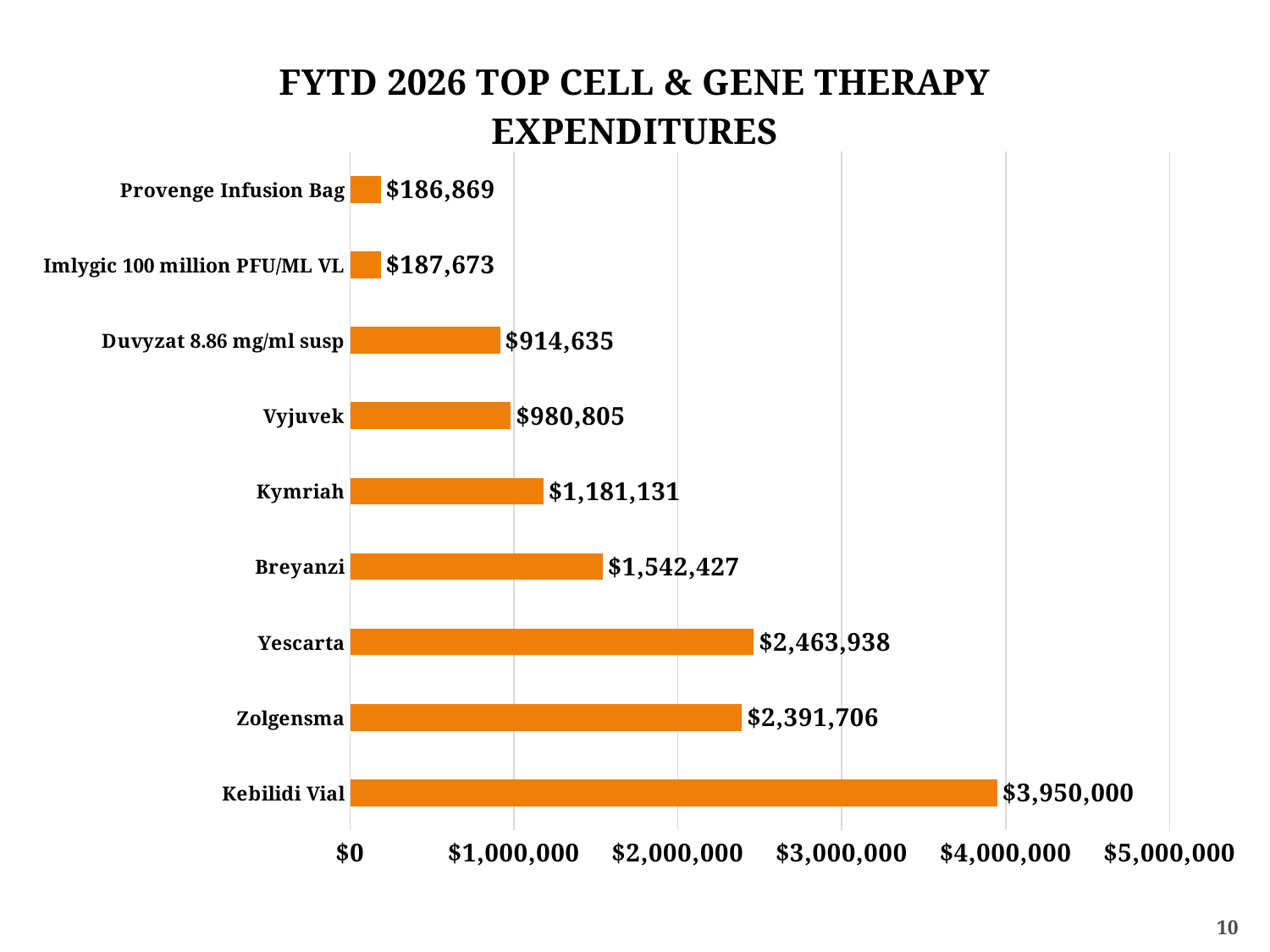
What is the expenditure for Vyjuvek? $980,805 What is the expenditure for Provenge Infusion Bag? $186,869 What is the expenditure for Yescarta? $2,463,938 Which therapy has the highest expenditure? Kebilidi Vial Which has a larger expenditure, Breyanzi or Kymriah? Breyanzi What is the expenditure for Kebilidi Vial? $3,950,000 What kind of chart is shown on the slide? bar chart What is the difference between the expenditures for Kebilidi Vial and Yescarta? $1,486,062 Is the expenditure for Breyanzi greater or less than $1,000,000? greater What is the difference between the expenditures for Yescarta and Zolgensma? $72,232 What is the title of the chart? FYTD 2026 TOP CELL & GENE THERAPY EXPENDITURES How many therapies are shown in the chart? 9